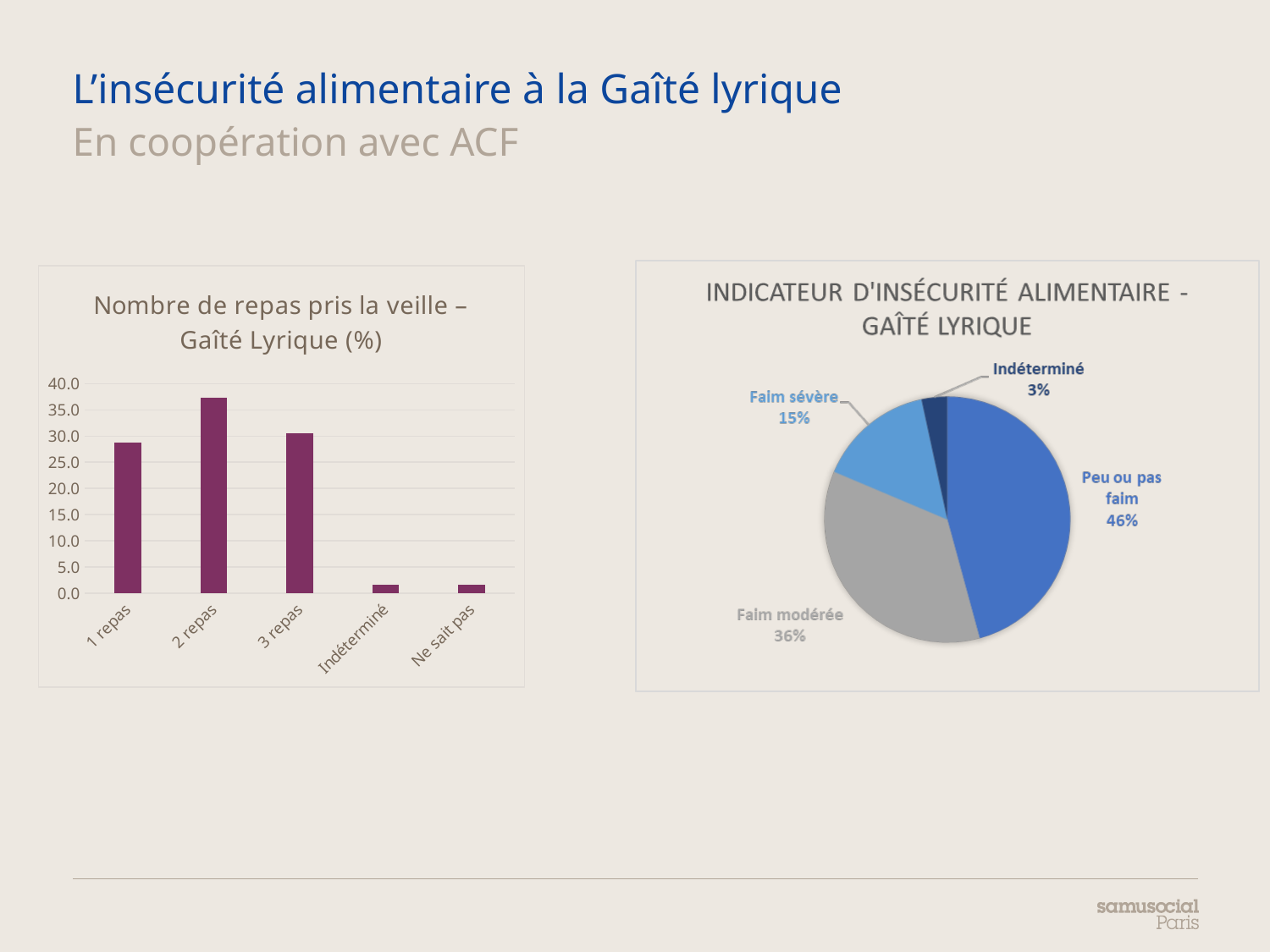
In the bar chart 'Nombre de repas pris la veille – Gaîté Lyrique (%)', which is larger, the value for 2 repas or the value for 1 repas? 2 repas In the bar chart 'Nombre de repas pris la veille – Gaîté Lyrique (%)', is the value for 2 repas greater or less than 35.0? greater In the bar chart 'Nombre de repas pris la veille – Gaîté Lyrique (%)', is the value for Indéterminé greater or less than 5.0? less In the bar chart 'Nombre de repas pris la veille – Gaîté Lyrique (%)', is the value for 1 repas greater or less than 25.0? greater In the pie chart 'Indicateur d'insécurité alimentaire - Gaîté Lyrique', what share is Faim modérée? 36% In the pie chart 'Indicateur d'insécurité alimentaire - Gaîté Lyrique', which slice is the smallest? Indéterminé How many categories are shown in the bar chart 'Nombre de repas pris la veille – Gaîté Lyrique (%)'? 5 In the bar chart 'Nombre de repas pris la veille – Gaîté Lyrique (%)', which category has the highest value? 2 repas What kind of chart is the chart on the left of the slide? bar chart In the pie chart 'Indicateur d'insécurité alimentaire - Gaîté Lyrique', which slice is the largest? Peu ou pas faim In the pie chart 'Indicateur d'insécurité alimentaire - Gaîté Lyrique', what is the difference between Peu ou pas faim and Faim modérée? 10% In the pie chart 'Indicateur d'insécurité alimentaire - Gaîté Lyrique', what is the value for Faim sévère? 15%